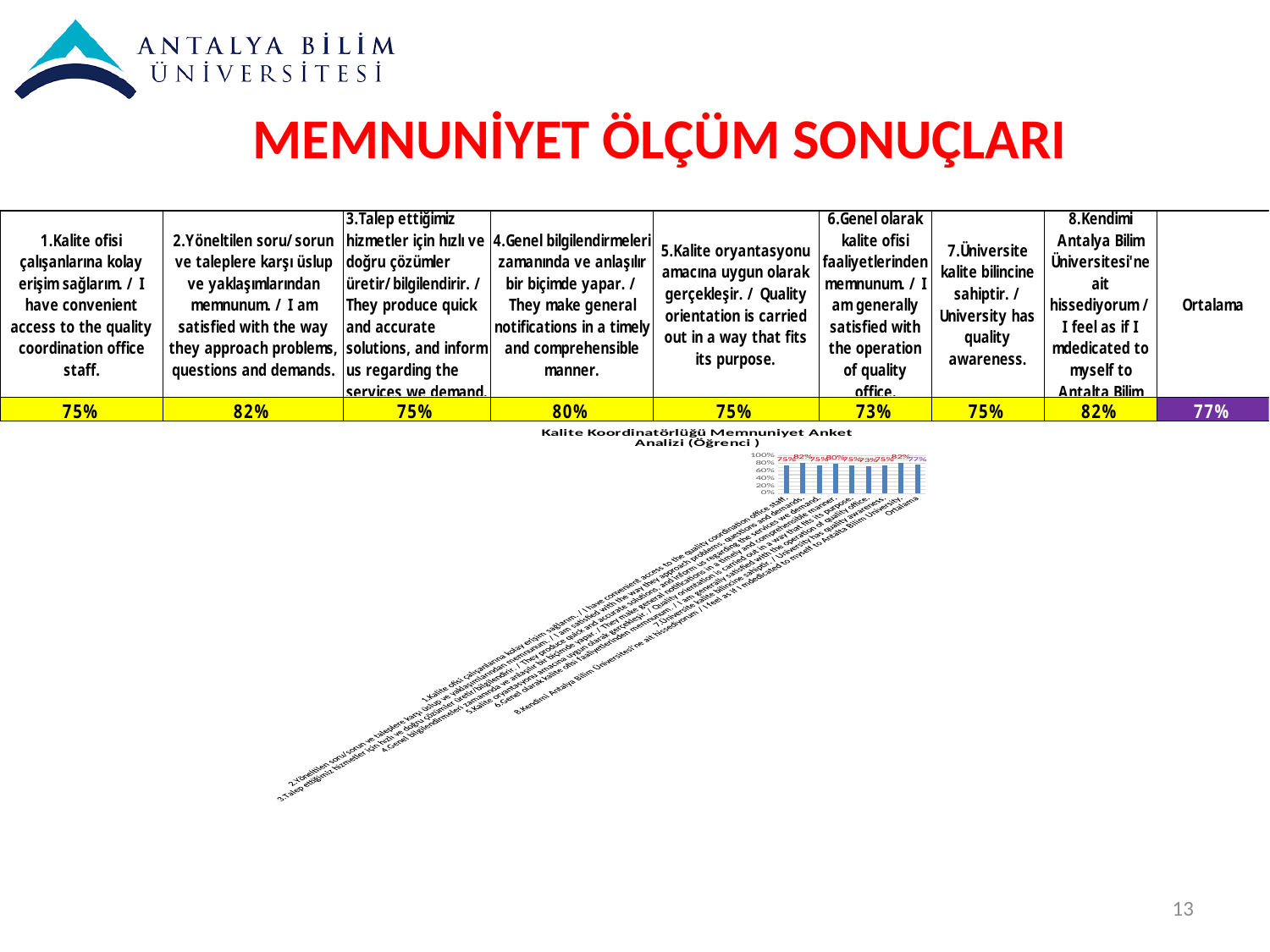
What is the highest value shown in the chart? 82% How many bars does the chart show? 9 Which is larger: the value for item 4 (Genel bilgilendirmeleri) or the value for item 5 (Kalite oryantasyonu)? item 4 (Genel bilgilendirmeleri) What is the title of the chart on the slide? Kalite Koordinatörlüğü Memnuniyet Anket Analizi (Öğrenci ) What is the value shown for item 2 (Yöneltilen soru/sorun ve taleplere karşı üslup ve yaklaşımlarından memnunum) in the chart? 82% What is the value shown for item 4 (Genel bilgilendirmeleri zamanında ve anlaşılır bir biçimde yapar) in the chart? 80% Which item has the lowest value in the chart? 6.Genel olarak kalite ofisi faaliyetlerinden memnunum What kind of chart is shown on the slide? bar chart What is the value shown for item 6 (Genel olarak kalite ofisi faaliyetlerinden memnunum) in the chart? 73% What is the difference between the value for item 2 (82%) and the value for item 6 (73%)? 9% What is the value of the 'Ortalama' bar in the chart? 77% Is the value for 'Ortalama' greater or less than 60%? greater